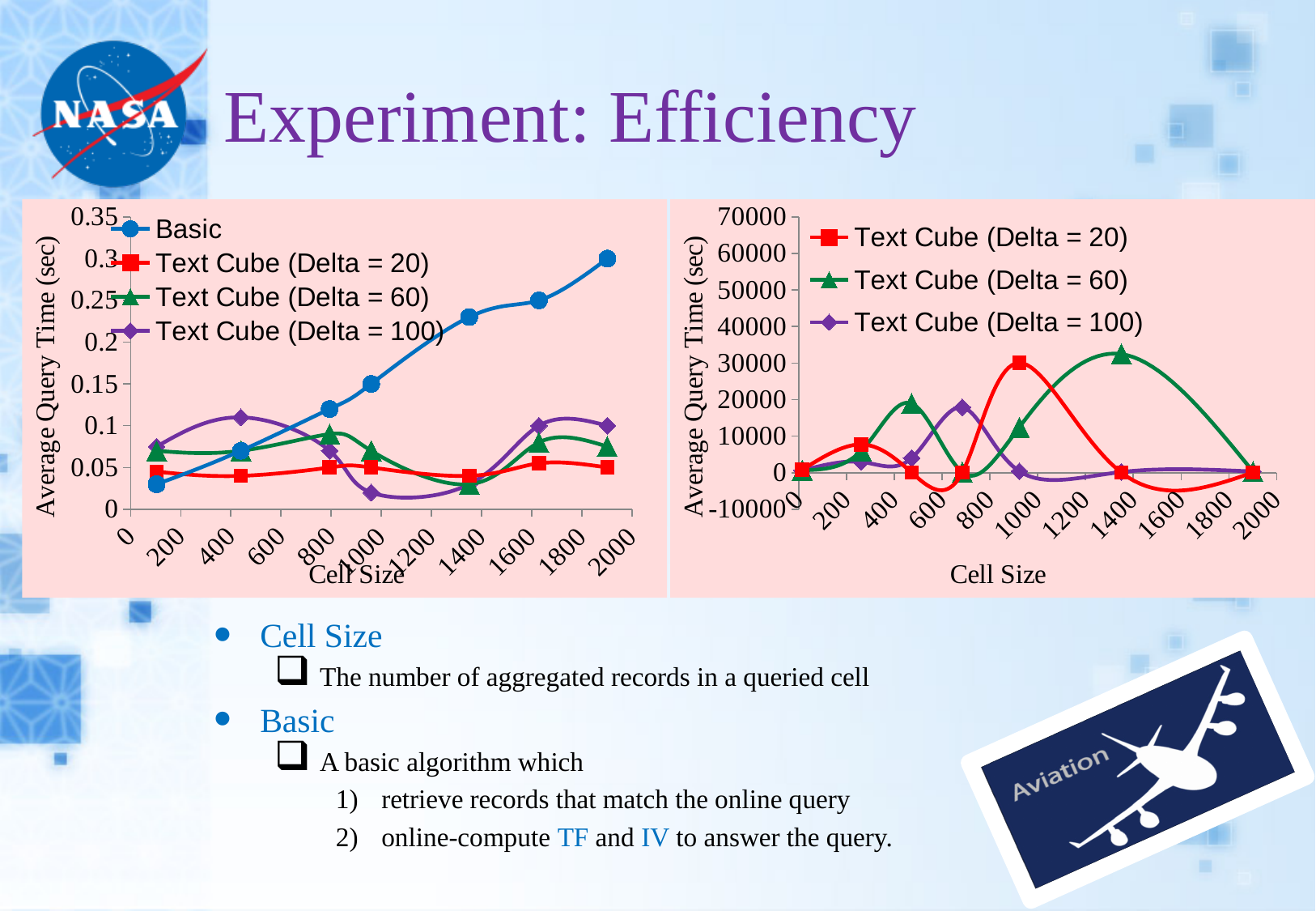
How many series does the legend of the left chart list? 4 In the right chart, is the value of Text Cube (Delta = 60) at cell size 1400 greater or less than 20000? greater What kind of chart is the left chart? line chart How many series does the legend of the right chart list? 3 In the left chart, at cell size around 1400, which is larger: Basic or Text Cube (Delta = 100)? Basic In the right chart, is the peak value of Text Cube (Delta = 20) at cell size 1000 greater or less than 20000? greater In the right chart, at cell size 1400, which is larger: Text Cube (Delta = 60) or Text Cube (Delta = 100)? Text Cube (Delta = 60) In the left chart, is the value for Basic at the largest cell size (around 1900) greater or less than 0.25? greater What is the label of the x axis on the right chart? Cell Size In the left chart, which series has the highest value at the largest cell size (around 1900)? Basic In the left chart, do the values for the Basic series rise or fall as cell size increases? rise